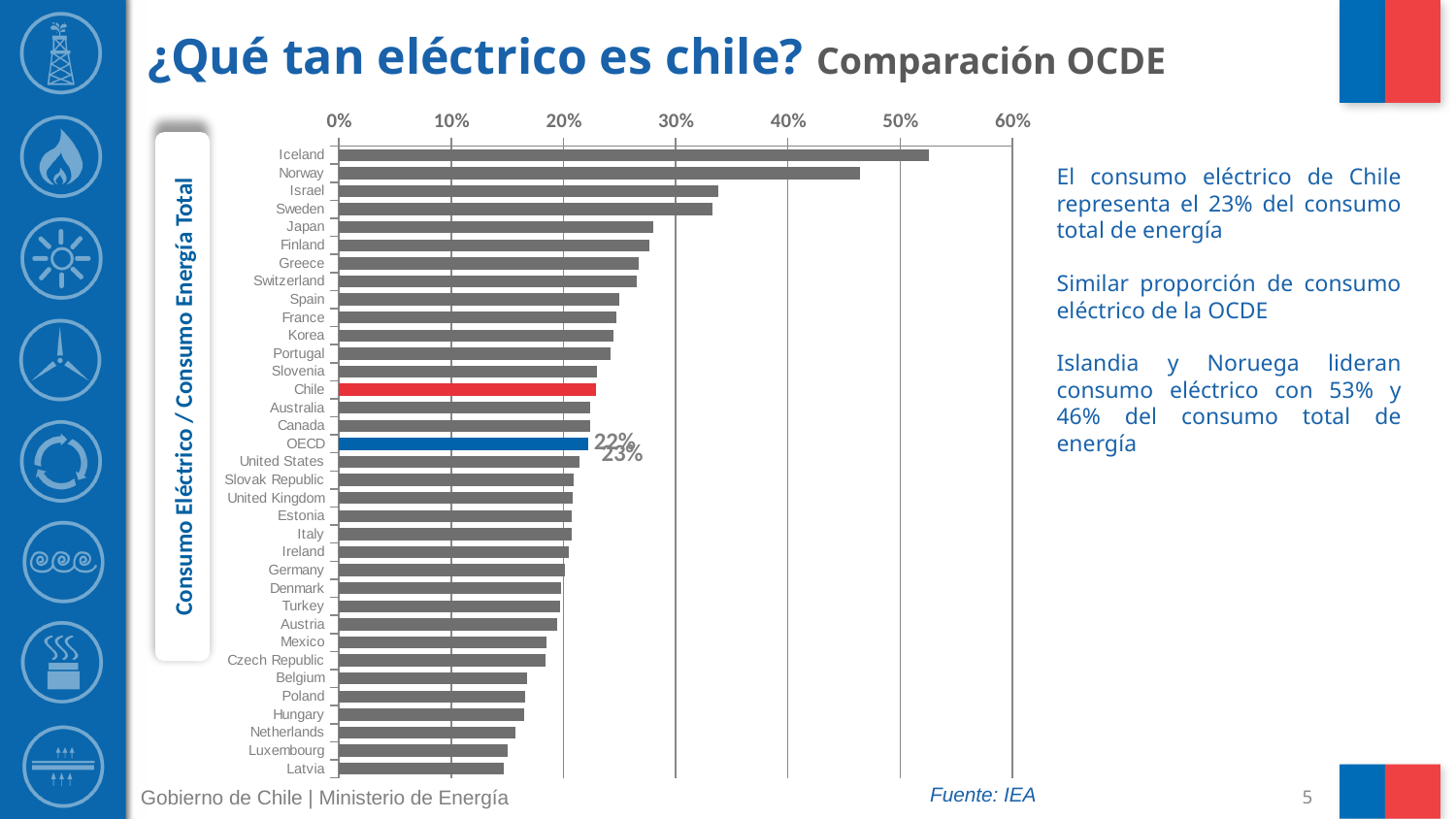
Which is larger, the value for Spain or the value for Belgium? Spain Is the value for Latvia greater or less than 20%? less How many categories (countries/groups) are plotted in the chart? 35 Is the value for Norway greater or less than 40%? greater Is the value for Iceland greater or less than 50%? greater What is the value shown for Chile? 23% Which is larger, the value for Iceland or the value for Norway? Iceland Which country has the highest share of electricity in total energy consumption? Iceland What is the label on the vertical axis of the chart? Consumo Eléctrico / Consumo Energía Total What kind of chart is shown on the slide? bar chart What colour is the bar for Chile? red